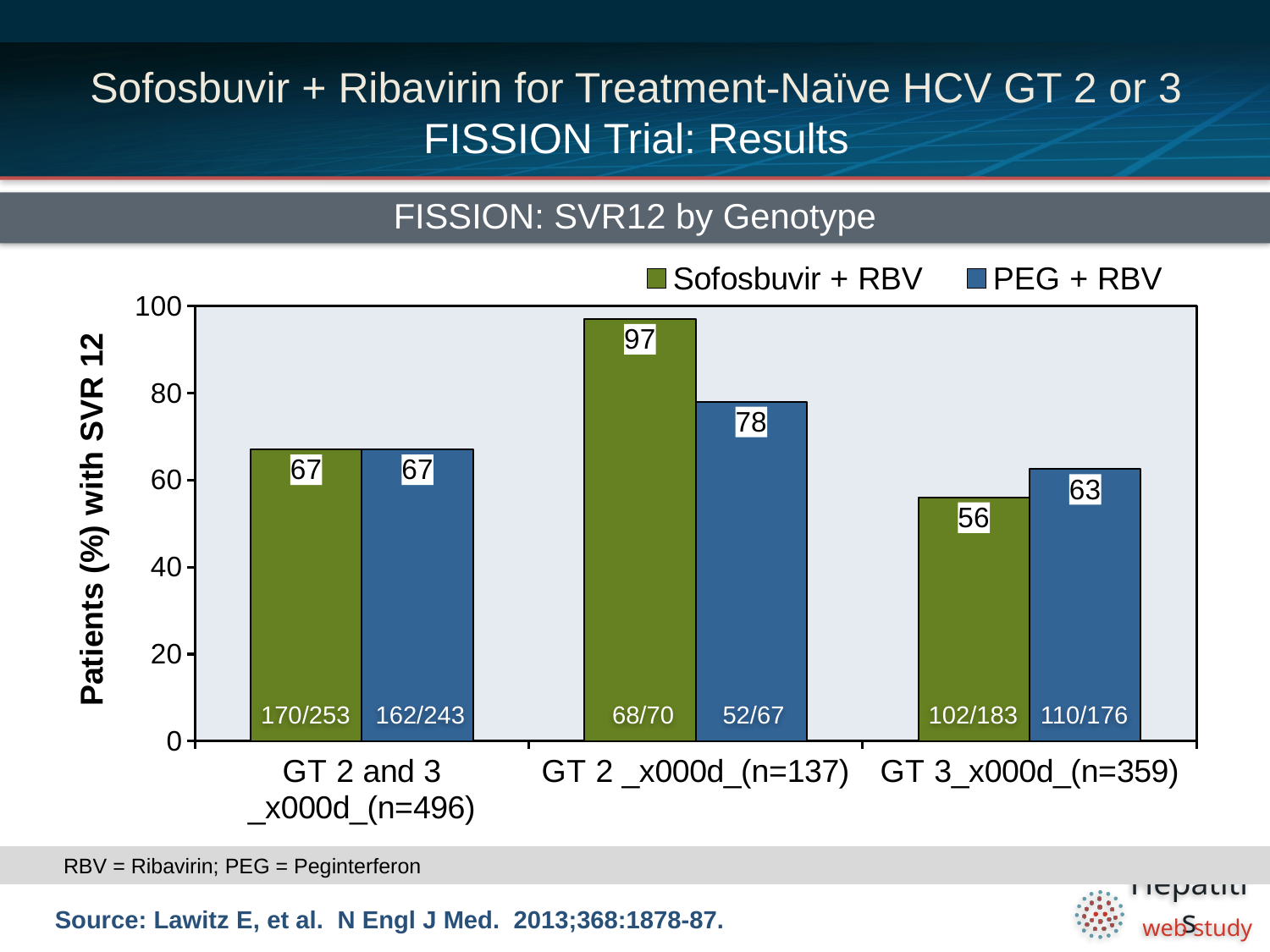
What is the SVR12 rate for PEG + RBV in the GT 3 (n=359) group? 63 How many genotype groups are shown on the x axis? 3 What is the SVR12 rate for Sofosbuvir + RBV in the GT 2 and 3 (n=496) group? 67 In the GT 3 (n=359) group, which treatment has the higher SVR12 rate, Sofosbuvir + RBV or PEG + RBV? PEG + RBV Which genotype group has the lowest SVR12 rate for Sofosbuvir + RBV? GT 3 (n=359) What is the SVR12 rate for Sofosbuvir + RBV in the GT 2 (n=137) group? 97 How many series does the legend list? 2 What kind of chart is shown on the slide? Bar chart What fraction of patients is shown inside the PEG + RBV bar for the GT 2 (n=137) group? 52/67 What is the title of the chart? FISSION: SVR12 by Genotype Which genotype group has the highest SVR12 rate for Sofosbuvir + RBV? GT 2 (n=137) What is the difference between the Sofosbuvir + RBV and PEG + RBV SVR12 rates in the GT 2 (n=137) group? 19